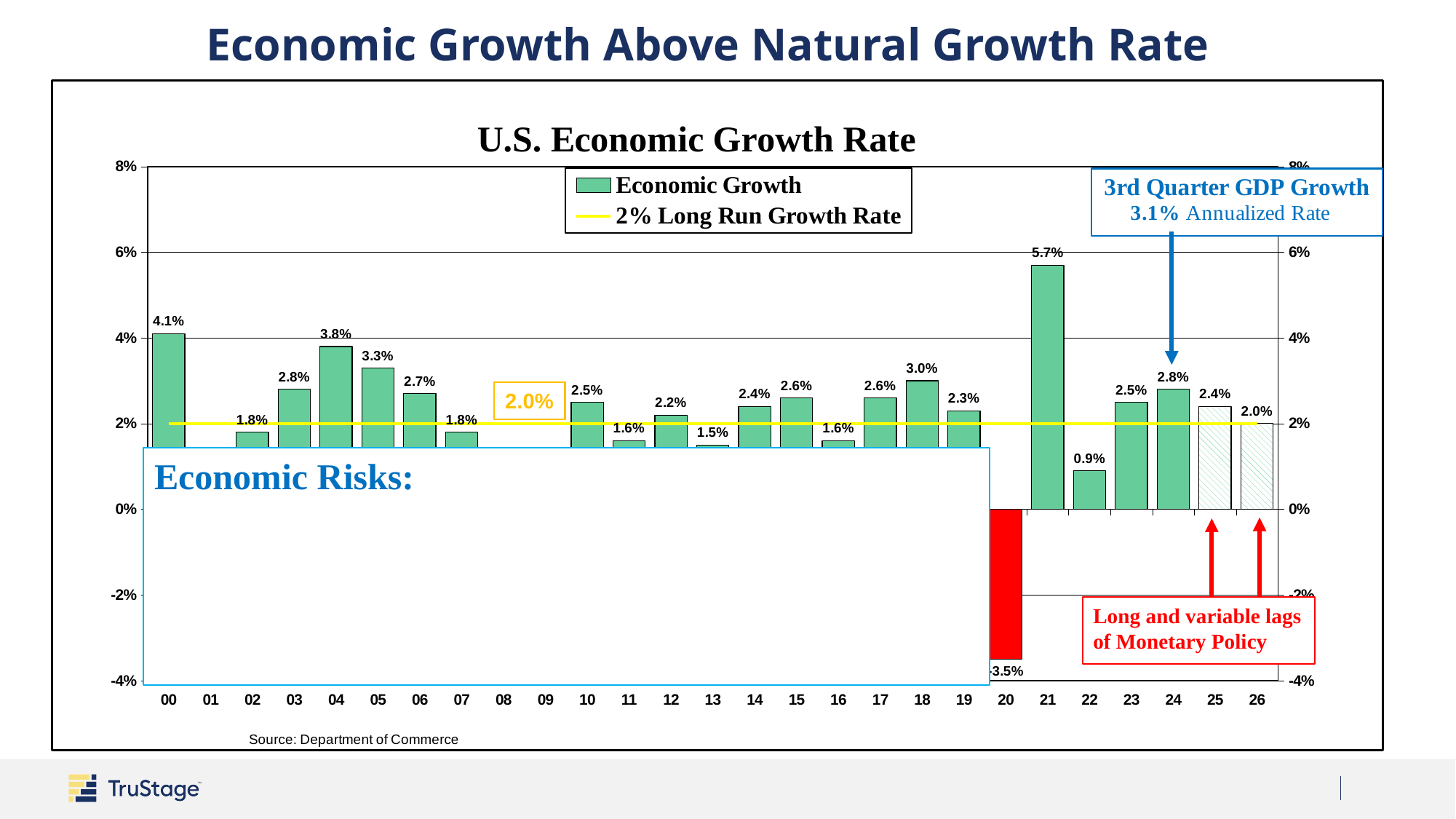
Which year has the highest economic growth rate on the chart? 21 What is the economic growth rate shown for 04? 3.8% Which year has a higher economic growth rate, 04 or 05? 04 How many series does the chart legend list? 2 What is the economic growth rate shown for 22? 0.9% What is the economic growth rate shown for 26? 2.0% What is the difference between the growth rate for 21 and the growth rate for 20? 9.2 percentage points What is the economic growth rate shown for 21? 5.7% What is the economic growth rate shown for 20? -3.5% What is the source cited for the chart? Department of Commerce What kind of chart is used to show the U.S. Economic Growth Rate? Combination bar and line chart Which year has the lowest economic growth rate on the chart? 20